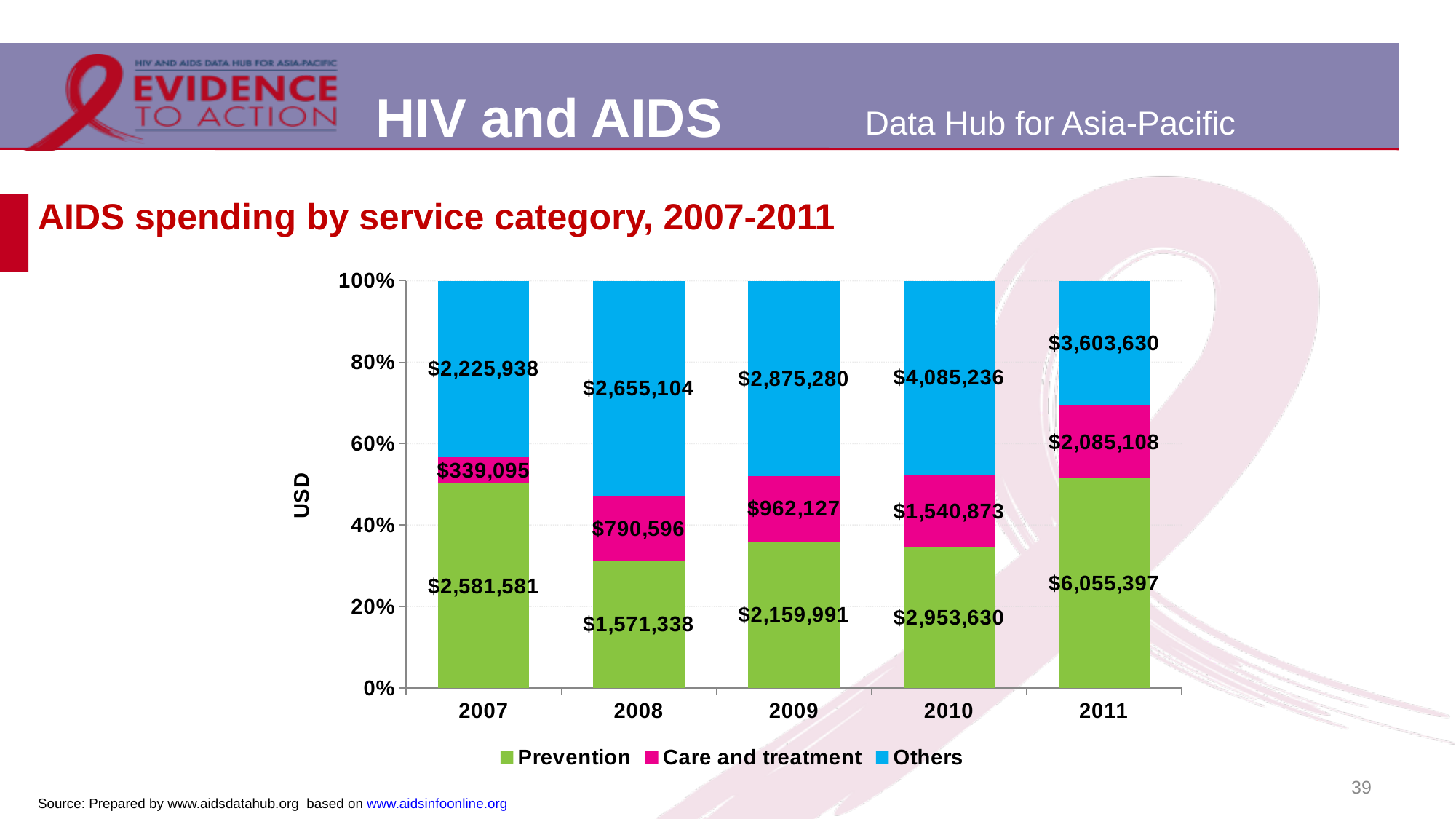
What was the Prevention spending in 2011? $6,055,397 How many series does the legend list? 3 Is the Prevention share of spending in 2008 greater or less than 40%? less How many years are shown on the x axis? 5 In which year was Care and treatment spending lowest? 2007 What is the total AIDS spending across all three categories in 2007? $5,146,614 What kind of chart is shown? Stacked bar chart What was the Others spending in 2010? $4,085,236 Which was larger in 2009: Prevention spending or Others spending? Others What was the Care and treatment spending in 2007? $339,095 How much more was spent on Prevention in 2011 than in 2010? $3,101,767 In which year was Prevention spending highest? 2011